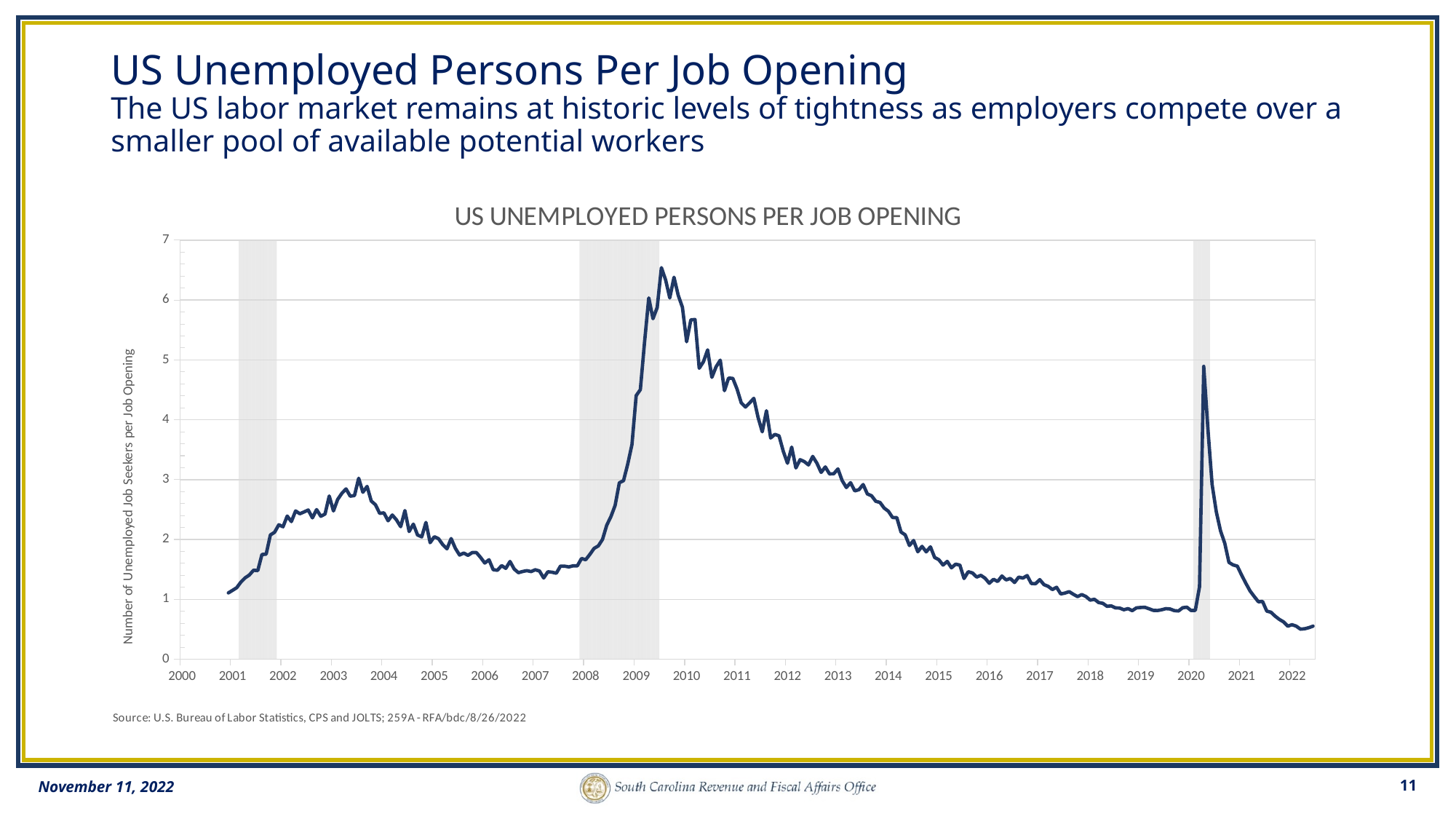
What kind of chart is shown on the slide? line chart Is the value in 2007 greater or less than 2? less Is the spike value reached in 2020 greater or less than 4? greater What is the label on the vertical axis of the chart? Number of Unemployed Job Seekers per Job Opening In which year does the line reach its highest value? 2009 Between 2010 and 2019, does the line generally rise or fall? fall What is the title of the chart? US UNEMPLOYED PERSONS PER JOB OPENING Is the value at the end of the line in 2022 greater or less than 1? less Between 2001 and 2003, does the line generally rise or fall? rise Which peak is higher, the one in 2009 or the one in 2020? 2009